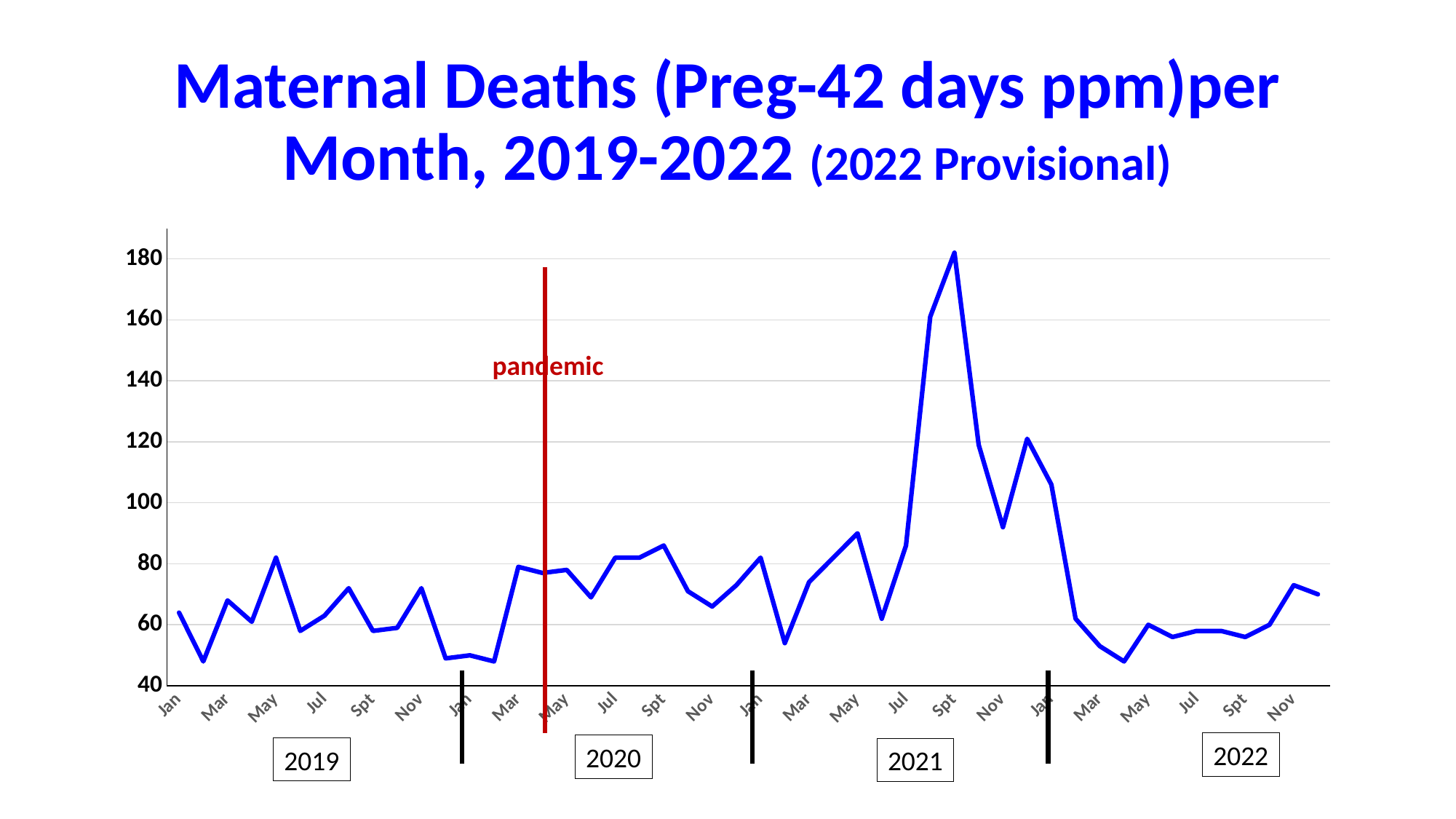
Is the value for Nov 2021 greater or less than 80? greater In which month of 2021 does the line reach its highest value? Spt Is the value for Jan 2022 greater or less than 100? greater What event does the red vertical line on the chart mark? pandemic What kind of chart is shown on the slide? line chart Does the line rise or fall between Jul 2021 and Spt 2021? rise Is the value for Spt 2021 greater or less than 160? greater Which is larger, the value for Jan 2022 or the value for Jan 2019? Jan 2022 What is the title of the chart? Maternal Deaths (Preg-42 days ppm)per Month, 2019-2022 (2022 Provisional) In which year does the line reach its highest point? 2021 How many years are labelled along the x axis of the chart? 4